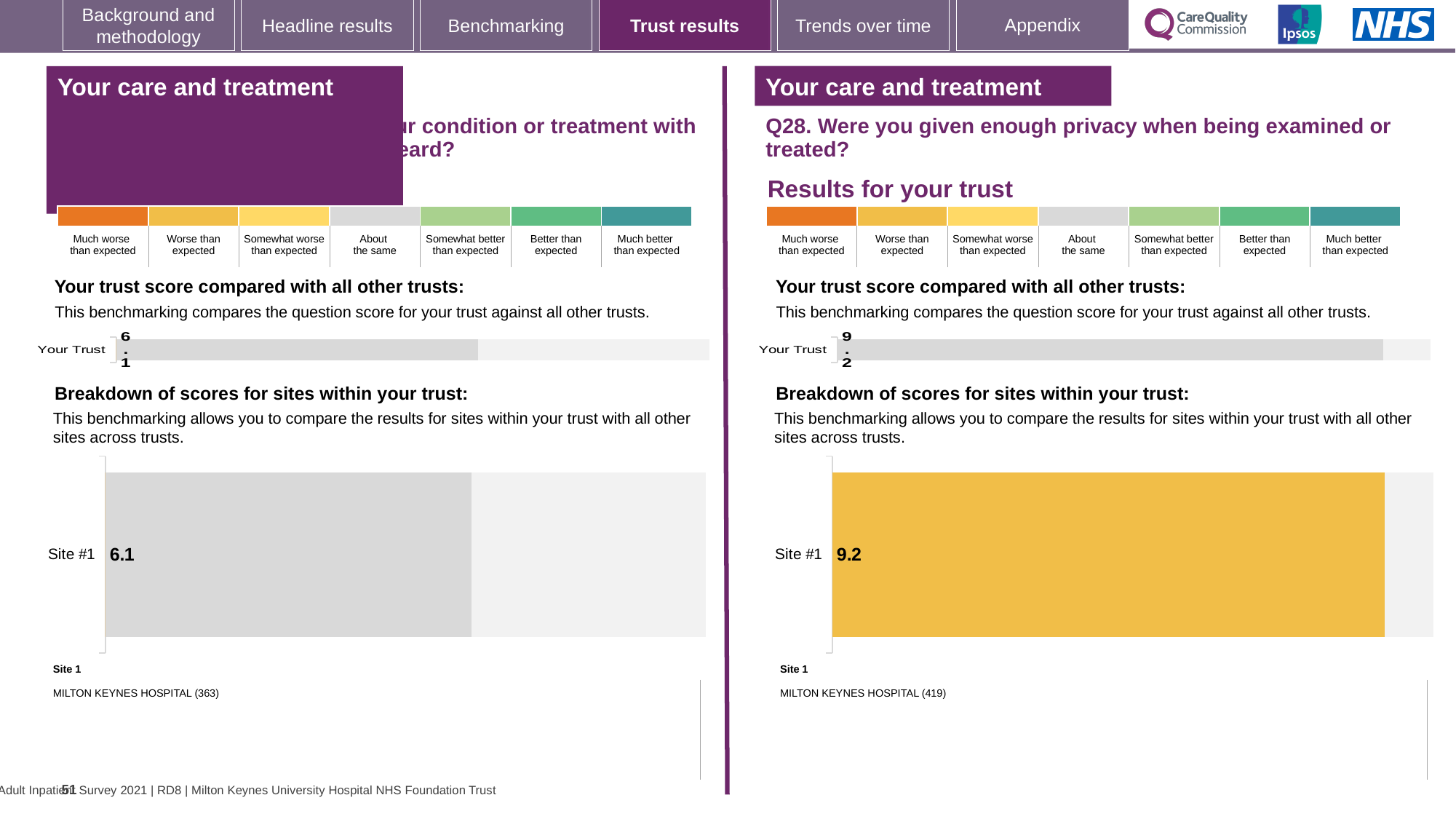
On the left-hand chart, what is the score shown for Your Trust? 6.1 Which is higher: the Site #1 score on the left-hand chart or the Site #1 score on the right-hand Q28 chart? The right-hand Q28 chart (9.2) Which hospital is listed as Site 1 beneath the right-hand Q28 breakdown chart? MILTON KEYNES HOSPITAL What is the difference between the Site #1 score on the right-hand Q28 chart and the Site #1 score on the left-hand chart? 3.1 On the right-hand chart for Q28 (privacy when being examined or treated), what is the score shown for Your Trust? 9.2 On the left-hand breakdown chart, what is the score for Site #1? 6.1 What number appears in parentheses after the Site 1 hospital name beneath the right-hand Q28 chart? 419 What type of chart is used to show the breakdown of scores for sites within the trust? Bar chart How many sites are shown in the right-hand breakdown chart for Q28? 1 On the right-hand Q28 chart, is the Your Trust score greater or less than the Your Trust score on the left-hand chart? greater On the right-hand breakdown chart for Q28, what is the score for Site #1? 9.2